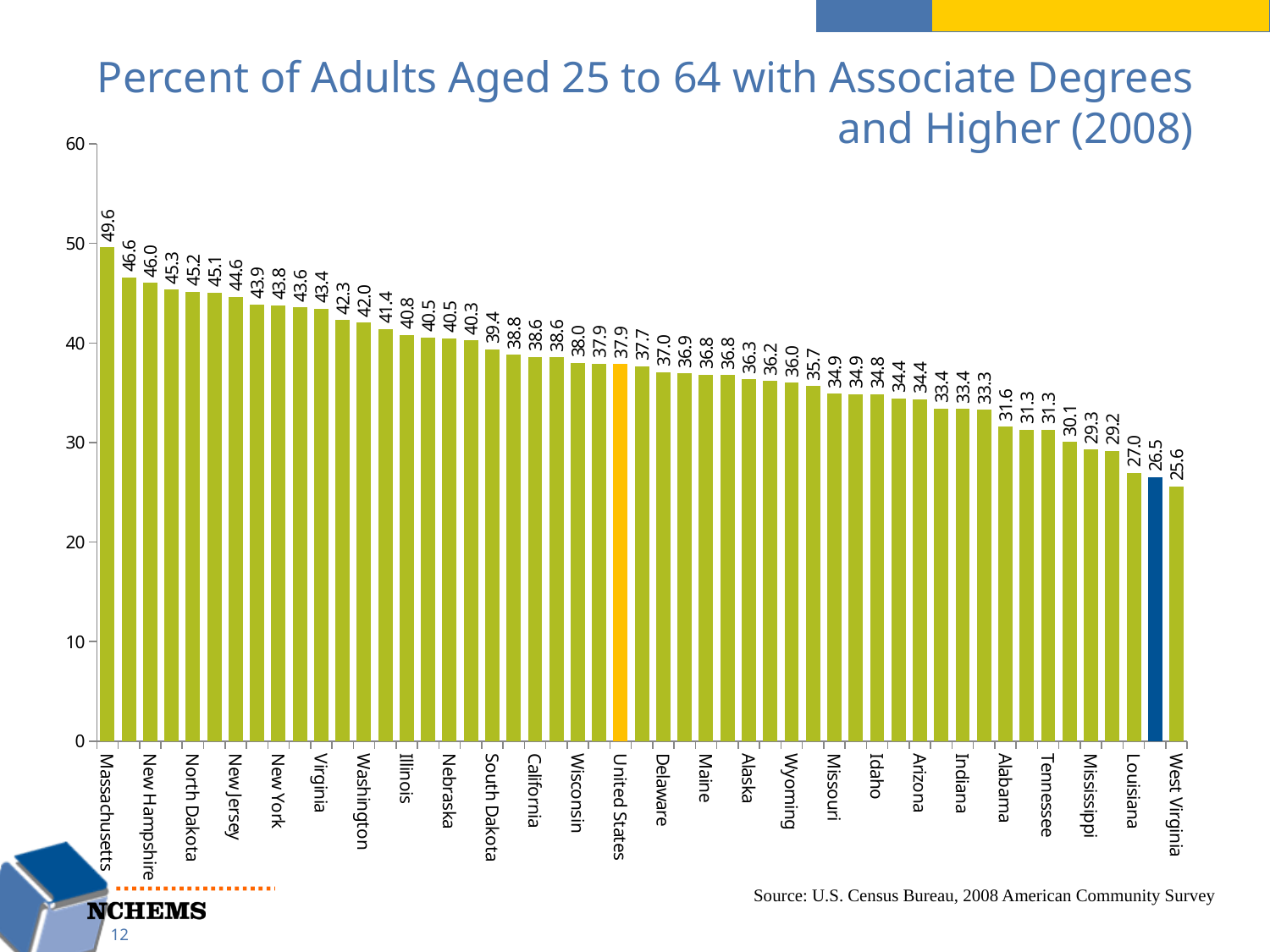
What is the value of the blue bar, second from the right? 26.5 Which is larger, the value for Massachusetts or the value for the United States? Massachusetts What is the value for the United States? 37.9 Is the value for West Virginia greater or less than 30? less What is the value for West Virginia? 25.6 Do the values rise or fall from left to right along the x axis? fall What type of chart is shown on the slide? bar chart What colour is the bar for the United States? yellow What is the difference between the values for Massachusetts and West Virginia? 24.0 What is the value for Massachusetts? 49.6 Which category has the lowest percent of adults aged 25 to 64 with associate degrees and higher? West Virginia Which category has the highest percent of adults aged 25 to 64 with associate degrees and higher? Massachusetts